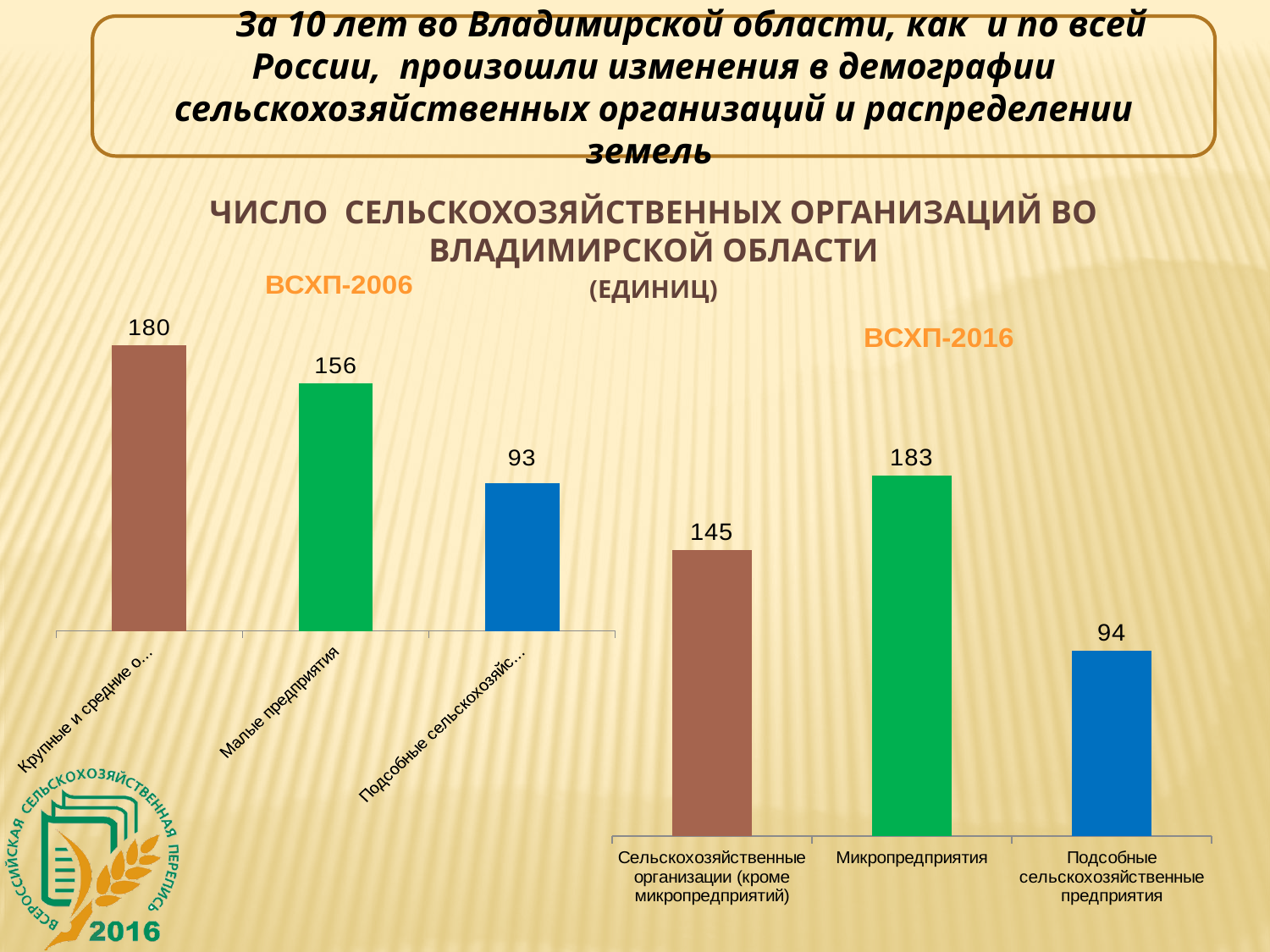
How many bars are in the ВСХП-2016 chart? 3 In the ВСХП-2016 chart, which category has the highest value? Микропредприятия In the ВСХП-2016 chart, what is the value for Микропредприятия? 183 In the ВСХП-2016 chart, which is larger: Микропредприятия or Подсобные сельскохозяйственные предприятия? Микропредприятия In the ВСХП-2016 chart, what is the value for Сельскохозяйственные организации (кроме микропредприятий)? 145 What type of chart is the ВСХП-2016 chart? Bar chart In the ВСХП-2016 chart, what is the value for Подсобные сельскохозяйственные предприятия? 94 In the ВСХП-2016 chart, what is the difference between Микропредприятия and Сельскохозяйственные организации (кроме микропредприятий)? 38 What is the value of the tallest bar in the ВСХП-2006 chart? 180 In the ВСХП-2006 chart, what is the value for Малые предприятия? 156 In the ВСХП-2016 chart, which category has the lowest value? Подсобные сельскохозяйственные предприятия How many bars are in the ВСХП-2006 chart? 3